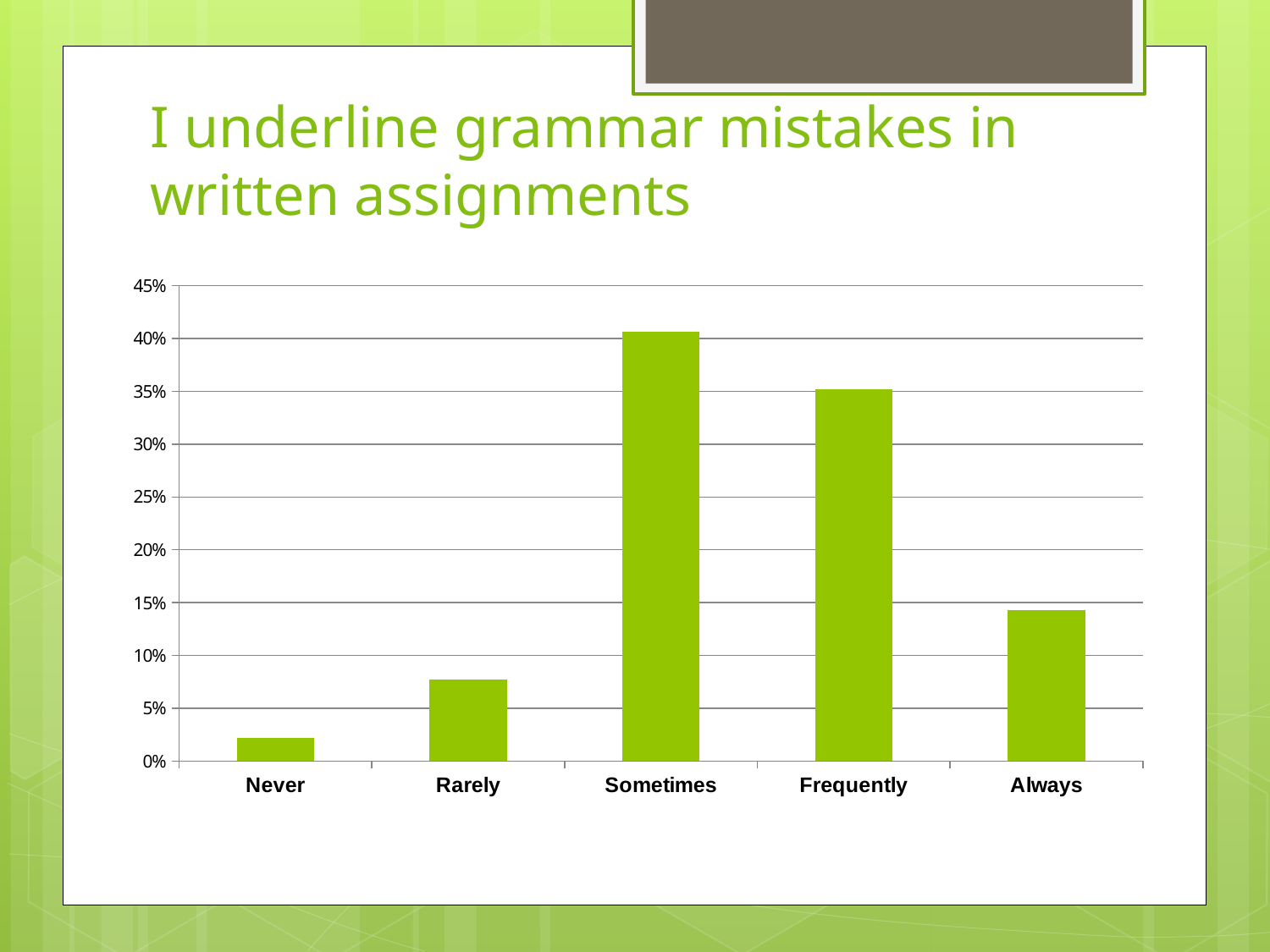
Is the value for Never greater or less than 5%? less Is the value for Always greater or less than 20%? less Which is larger, the value for Frequently or the value for Always? Frequently Is the value for Rarely greater or less than 10%? less How many categories are shown on the x axis? 5 Which category has the lowest value? Never What is the title of the slide containing the chart? I underline grammar mistakes in written assignments Which category has the highest value? Sometimes What kind of chart is shown on the slide? bar chart